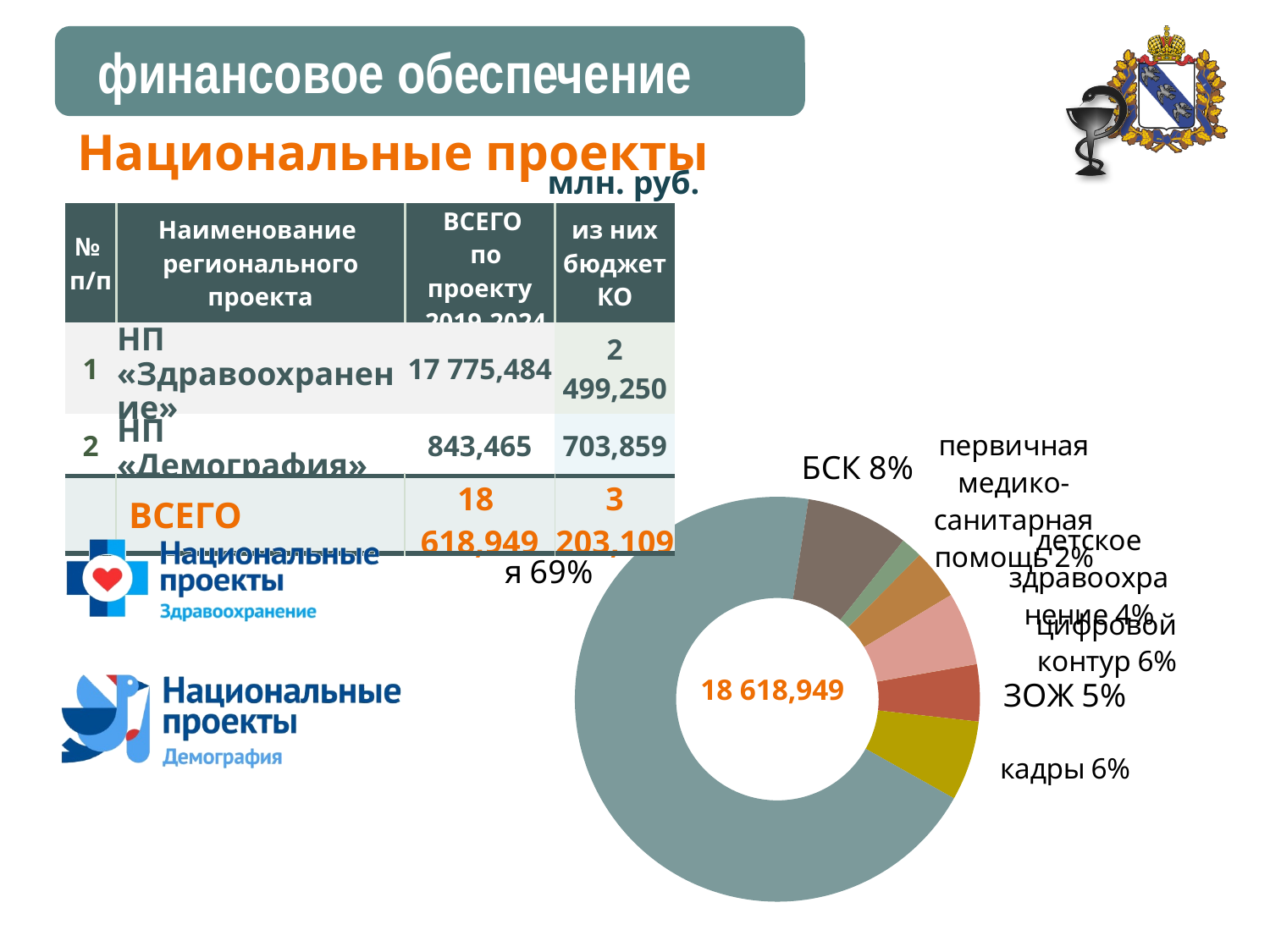
By how many percentage points does the share of БСК exceed the share of ЗОЖ? 3% What is the share of the largest slice in the pie chart? 69% How many slices does the pie chart have? 7 What share of the pie chart does ЗОЖ have? 5% Which slice of the pie chart has the smallest share? первичная медико-санитарная помощь Which has a larger share in the pie chart, БСК or ЗОЖ? БСК What share of the pie chart does БСК have? 8% What kind of chart is shown on the slide? doughnut chart Which has a larger share in the pie chart, кадры or ЗОЖ? кадры What value is printed in the centre of the pie chart? 18 618,949 What share of the pie chart does первичная медико-санитарная помощь have? 2%